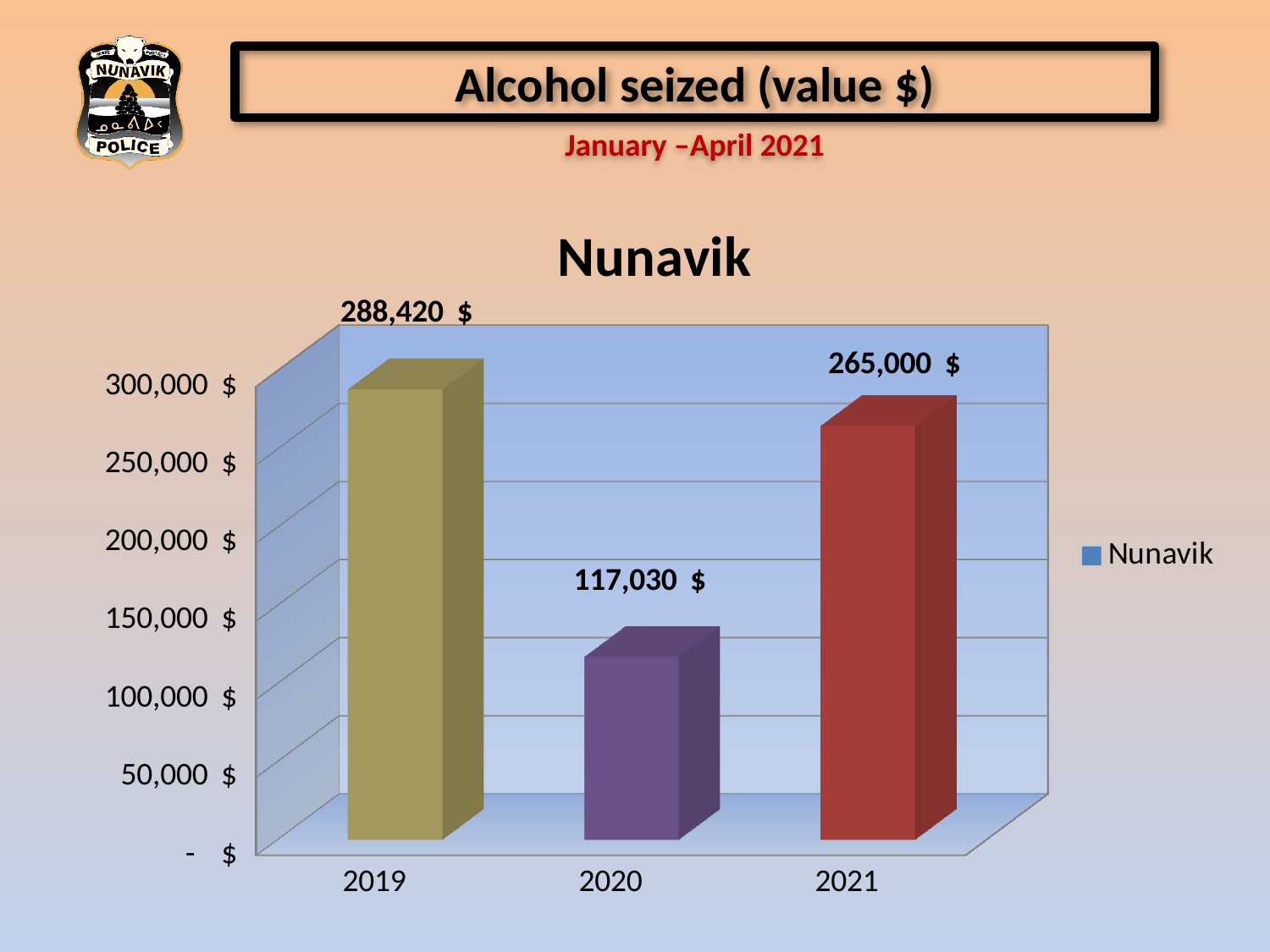
What is the value of alcohol seized in Nunavik in 2020? 117,030 $ Which year has the lowest value of alcohol seized? 2020 What is the value of alcohol seized in Nunavik in 2021? 265,000 $ Which year has a larger value of alcohol seized, 2020 or 2021? 2021 How many years are shown on the chart? 3 What is the value of alcohol seized in Nunavik in 2019? 288,420 $ What is the title of the chart? Nunavik Which year has the highest value of alcohol seized? 2019 What kind of chart is shown on the slide? Bar chart What is the difference between the 2019 and 2021 values of alcohol seized? 23,420 $ What is the difference between the 2021 and 2020 values of alcohol seized? 147,970 $ Is the value for 2020 greater or less than 150,000 $? less